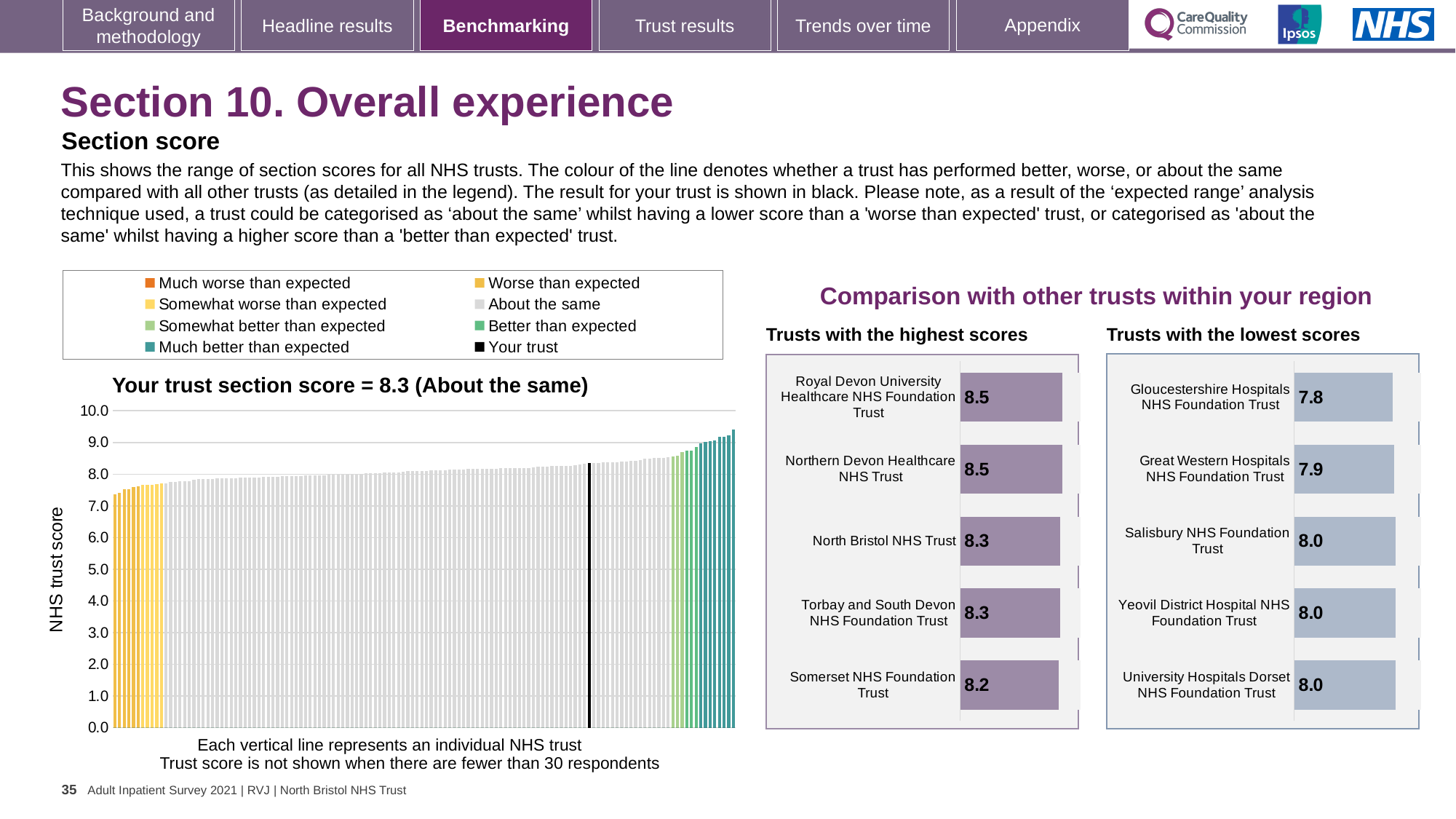
In the 'Trusts with the lowest scores' chart, which trust has the lowest score? Gloucestershire Hospitals NHS Foundation Trust In the 'Your trust section score' chart, is the value of the leftmost (lowest) bar greater or less than 7.0? greater In the 'Trusts with the highest scores' chart, what is the score for Somerset NHS Foundation Trust? 8.2 How many entries does the legend above the 'Your trust section score' chart list? 8 In the 'Trusts with the lowest scores' chart, what is the score for Great Western Hospitals NHS Foundation Trust? 7.9 What is the y-axis label of the 'Your trust section score' chart? NHS trust score In the 'Your trust section score' chart, what kind of chart is shown? Bar chart In the 'Trusts with the highest scores' chart, how many trusts are shown? 5 In the 'Your trust section score' chart, do the bars rise or fall from left to right? Rise In the 'Trusts with the highest scores' chart, what is the difference between the scores of Royal Devon University Healthcare NHS Foundation Trust and Somerset NHS Foundation Trust? 0.3 In the 'Your trust section score' chart, is the value of the rightmost (highest) bar greater or less than 9.0? greater In the 'Your trust section score' chart, what is the section score for your trust? 8.3